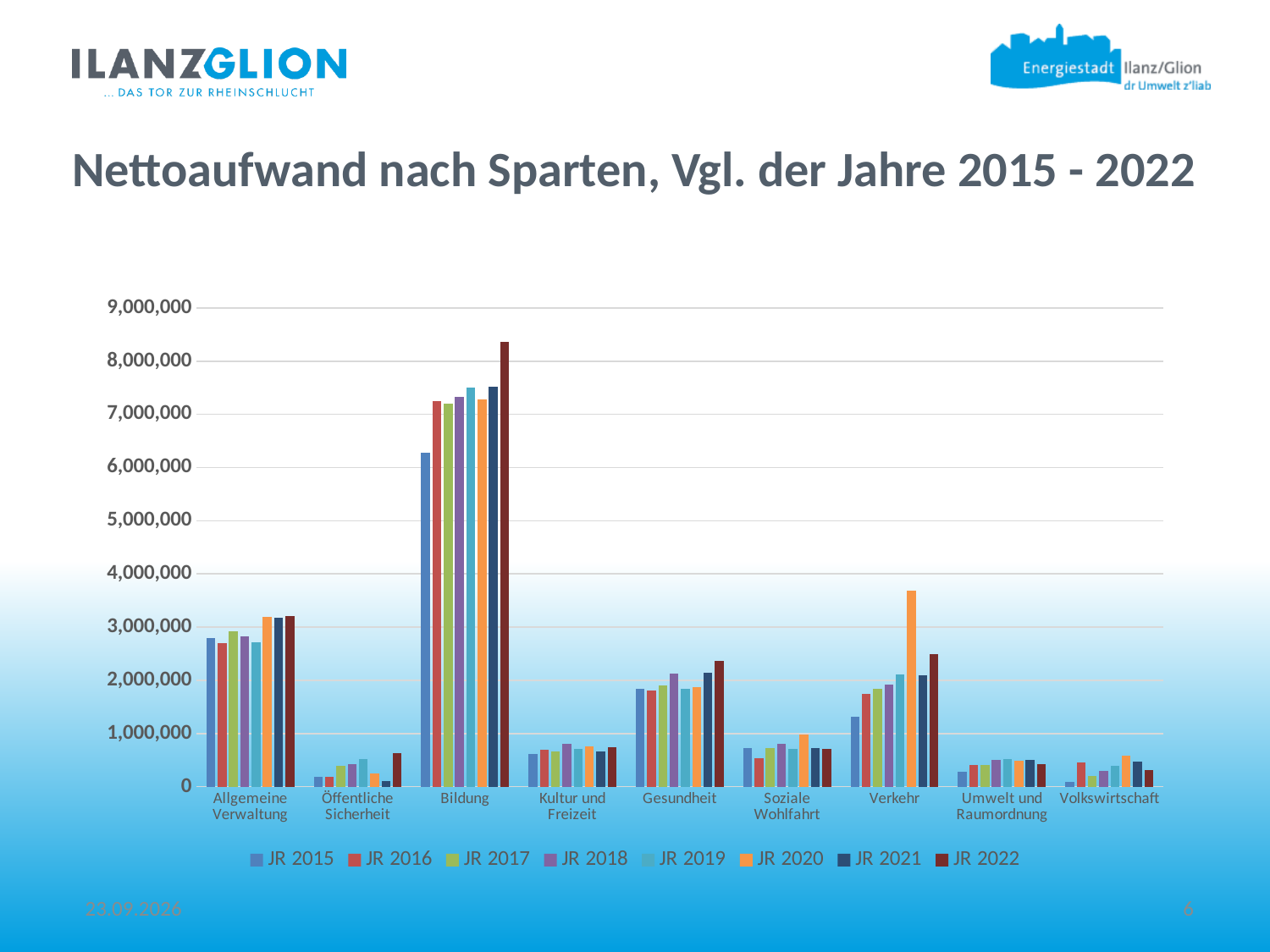
What kind of chart is shown on the slide? bar chart How many categories (Sparten) are shown on the x axis? 9 How many series does the legend list? 8 Which category has the highest bars overall? Bildung Within the Bildung category, which year has the highest value? JR 2022 Within the Verkehr category, which year has the highest value? JR 2020 Is the value for Verkehr in JR 2020 greater or less than 3,000,000? greater Is the value for Bildung in JR 2022 greater or less than 8,000,000? greater Is the value for Öffentliche Sicherheit in JR 2015 greater or less than 1,000,000? less Which is larger: Gesundheit in JR 2022 or Kultur und Freizeit in JR 2022? Gesundheit in JR 2022 Which is larger: Bildung in JR 2022 or Bildung in JR 2015? Bildung in JR 2022 What is the title of the chart? Nettoaufwand nach Sparten, Vgl. der Jahre 2015 - 2022